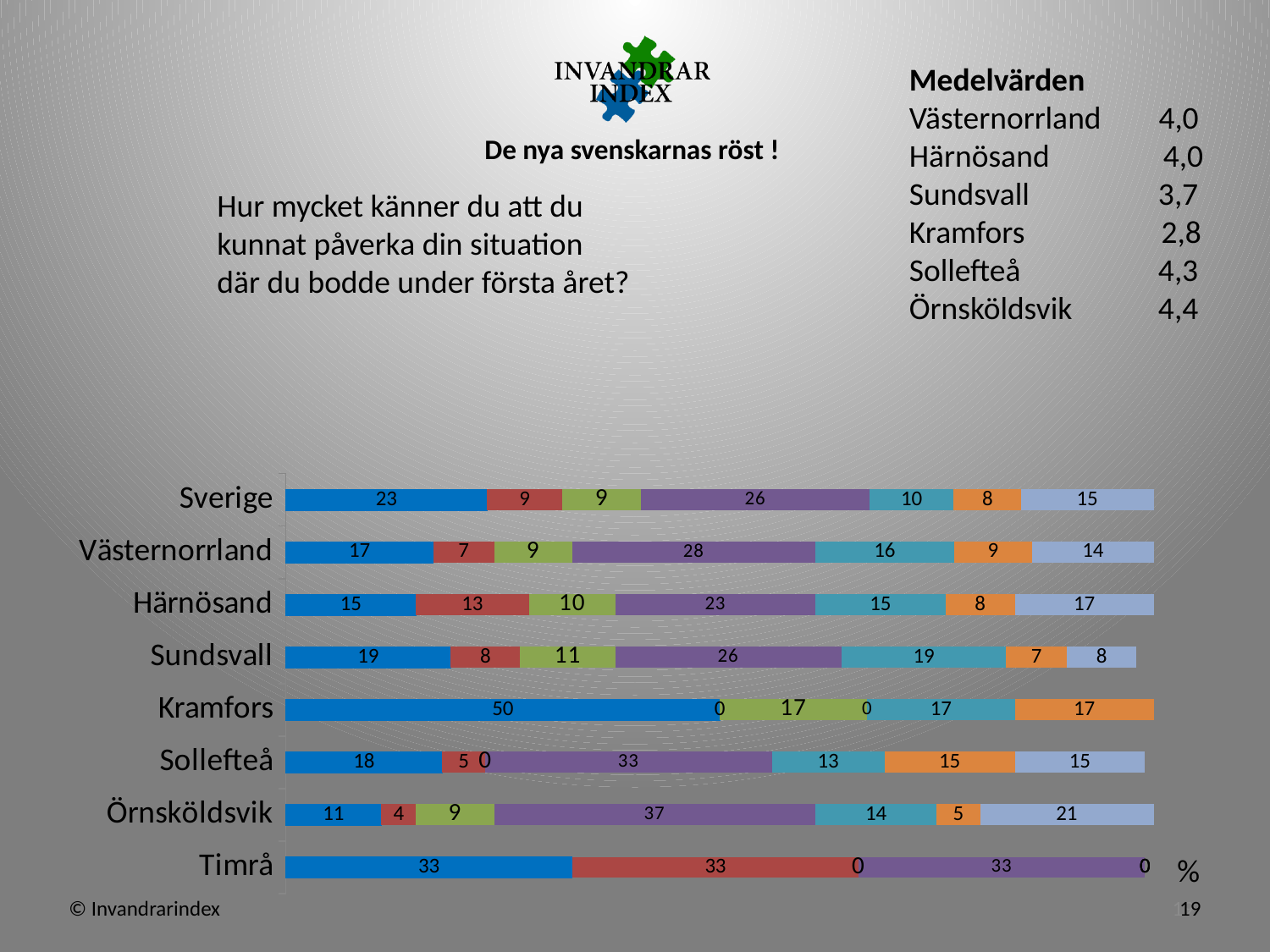
How many categories (rows) does the bar chart show? 8 What is the total of all segments in the Västernorrland bar? 100 Which category has the largest first (dark blue) segment? Kramfors What is the difference between the first (dark blue) segment of Sverige and that of Västernorrland? 6 What unit symbol is printed at the end of the horizontal axis? % Which is larger, the purple segment for Sollefteå or the purple segment for Härnösand? Sollefteå What is the value of the first (dark blue) segment for Sverige? 23 What kind of chart is shown on the slide? bar chart Which category has the smallest first (dark blue) segment? Örnsköldsvik What is the value of the purple segment for Örnsköldsvik? 37 What is the total of all segments in the Sverige bar? 100 What is the value of the first (dark blue) segment for Kramfors? 50